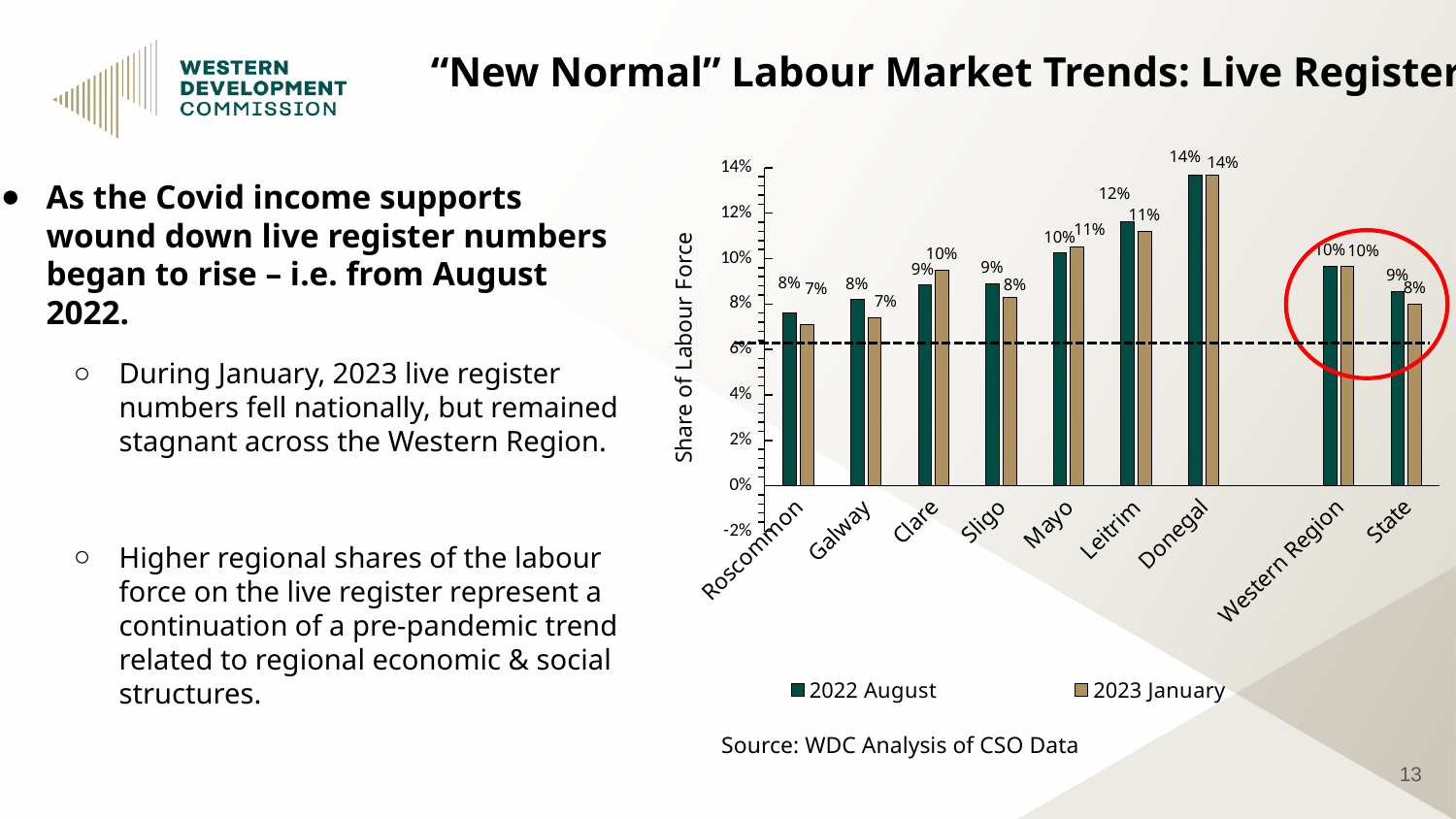
Which is larger, the 2023 January value for Clare or the 2023 January value for Sligo? Clare What is the difference between the 2022 August and 2023 January values for Leitrim? 1 percentage point How many categories are shown on the x axis of the chart? 9 Is the 2022 August value for Donegal greater or less than 12%? greater What is the 2023 January value for Mayo? 11% What is the 2023 January value for the State? 8% What is the 2022 August value for Leitrim? 12% What kind of chart is shown on the slide? Bar chart What is the title of the chart's vertical axis? Share of Labour Force What is the 2022 August value for Donegal? 14% How many series does the chart's legend list? 2 Which category has the highest 2022 August value? Donegal